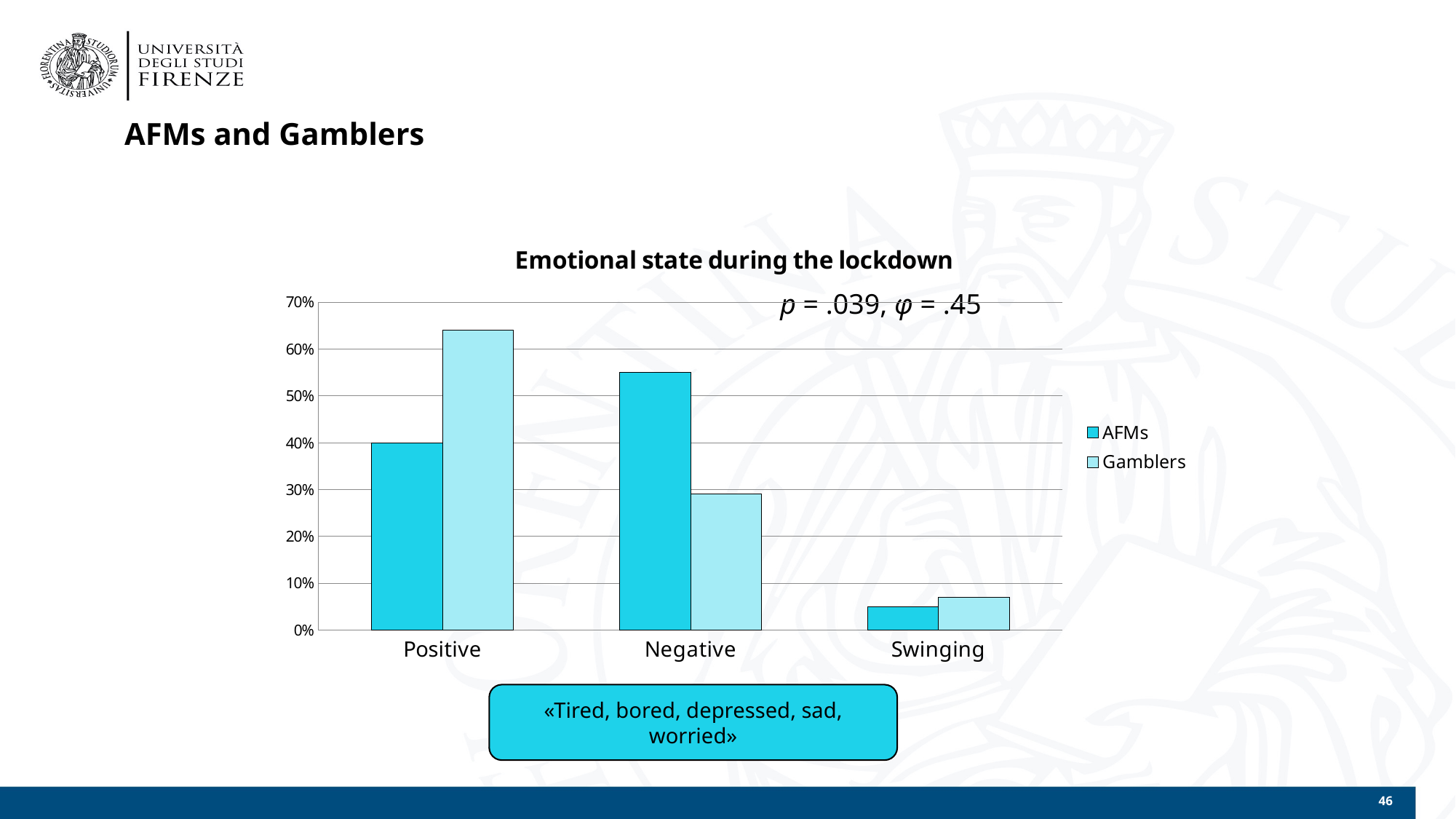
How many categories are shown on the x axis? 3 Which category has the highest value for AFMs? Negative How many series does the legend list? 2 What type of chart is shown on the slide? bar chart In the Negative category, which series has the larger value, AFMs or Gamblers? AFMs What is the title of the chart? Emotional state during the lockdown Is the value for AFMs in the Negative category greater or less than 50%? greater Is the value for Gamblers in the Positive category greater or less than 60%? greater Which category has the lowest value for AFMs? Swinging In the Positive category, which series has the larger value, AFMs or Gamblers? Gamblers Which category has the highest value for Gamblers? Positive